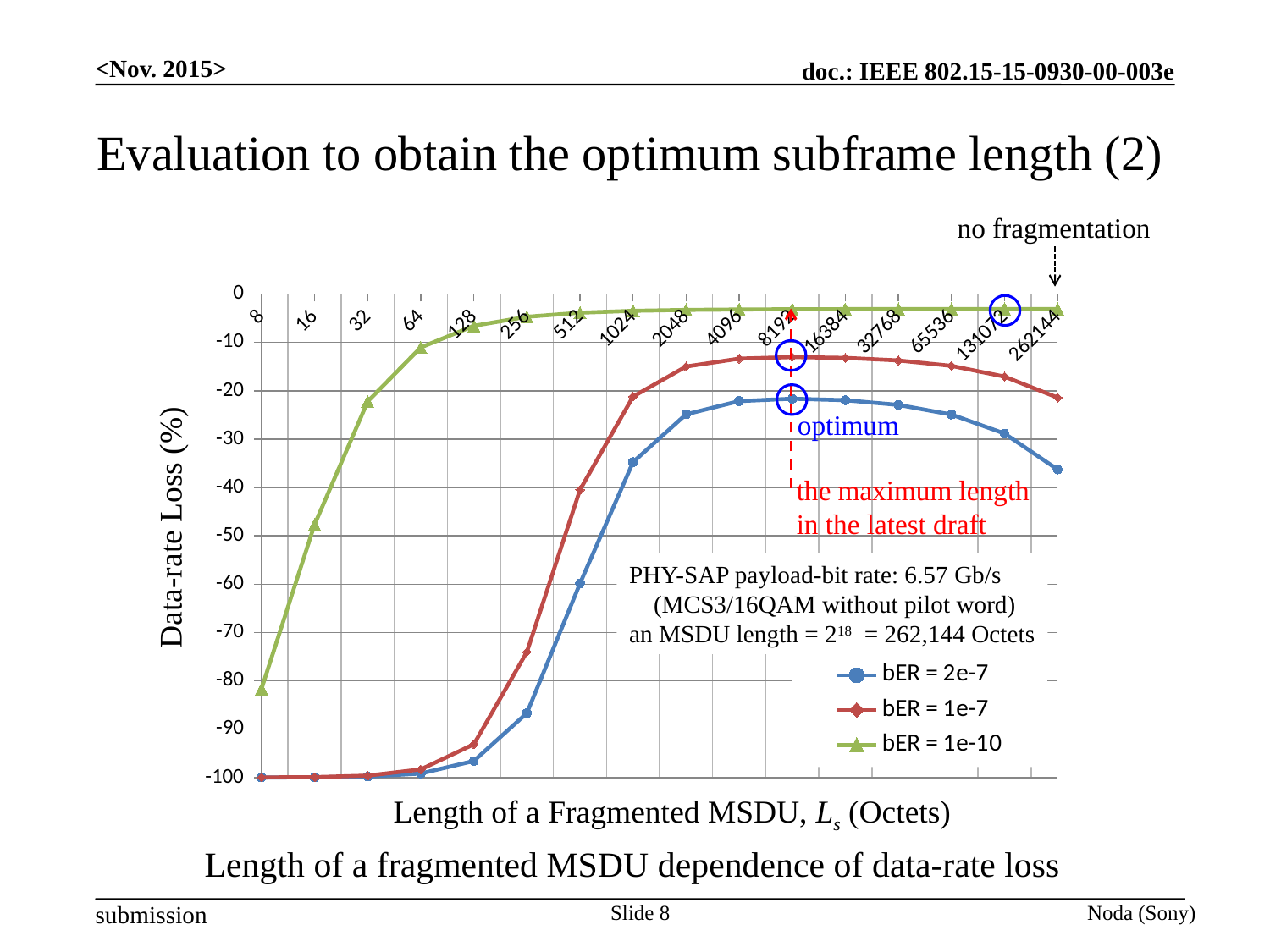
Does the bER = 2e-7 series rise or fall as the length increases from 8 to 8192 octets? rise What is the title of the y axis? Data-rate Loss (%) What kind of chart is shown on the slide? line chart Is the value for bER = 1e-10 at a length of 128 octets greater or less than -10? greater Is the value for bER = 1e-10 at a length of 16 octets greater or less than -40? less Which series has the highest data-rate loss value at a length of 8192 octets? bER = 1e-10 Which series has the lowest data-rate loss value at a length of 8192 octets? bER = 2e-7 How many points are plotted along the x axis for each series? 16 How many series does the legend list? 3 At a length of 512 octets, which series has the larger value: bER = 1e-7 or bER = 2e-7? bER = 1e-7 What is the value of the bER = 1e-7 series at a fragmented MSDU length of 16 octets? -100 What is the value of the bER = 2e-7 series at a fragmented MSDU length of 8 octets? -100